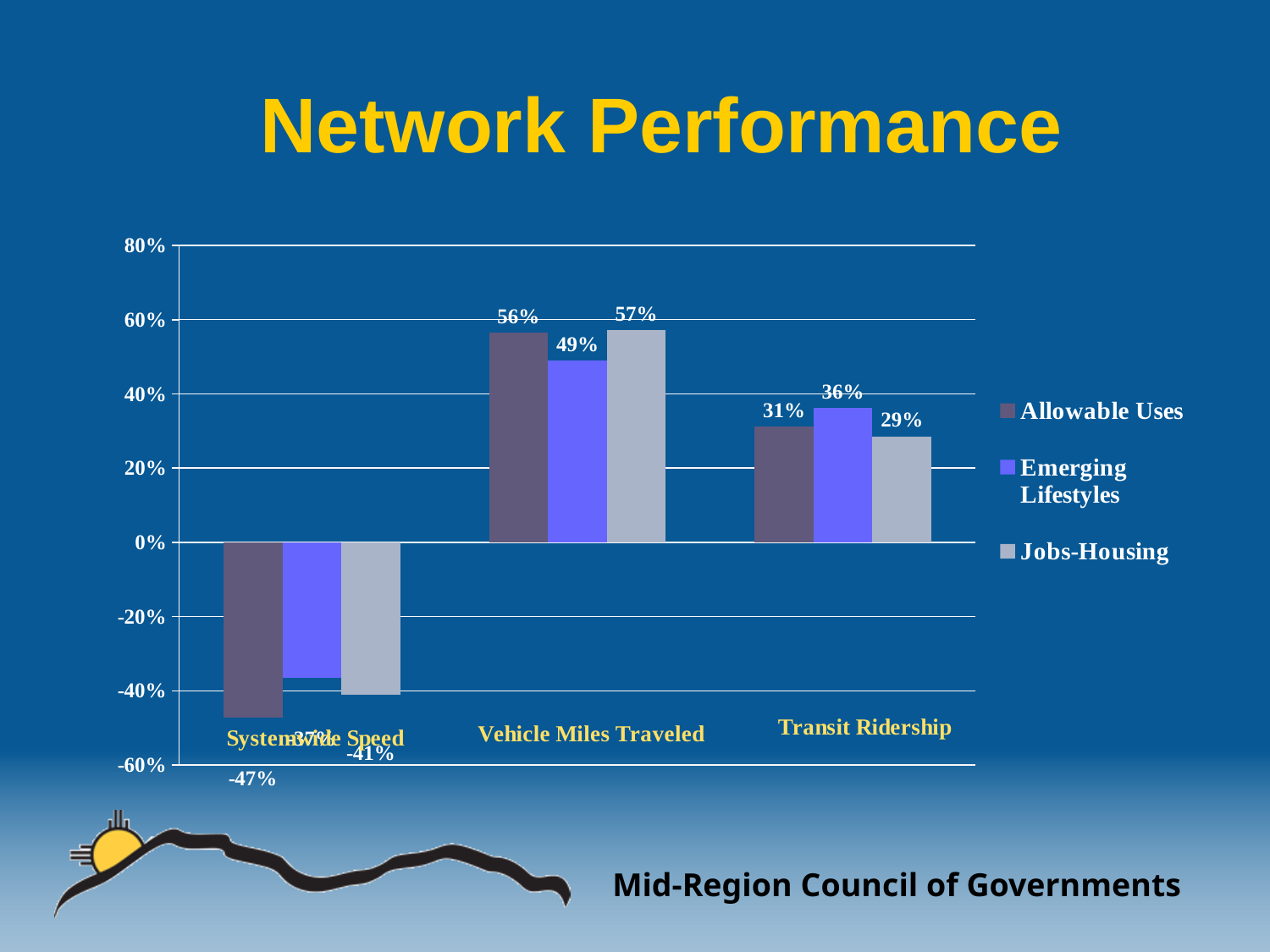
What is the value for Allowable Uses in the Systemwide Speed category? -47% Which series has the highest value in the Vehicle Miles Traveled category? Jobs-Housing What is the value for Allowable Uses in the Vehicle Miles Traveled category? 56% Is the value for Emerging Lifestyles in the Systemwide Speed category greater or less than -20%? less What is the value for Jobs-Housing in the Transit Ridership category? 29% Which series has the lowest value in the Transit Ridership category? Jobs-Housing What kind of chart is shown on the slide? bar chart What is the difference between the Jobs-Housing and Emerging Lifestyles values in the Vehicle Miles Traveled category? 8% How many categories are shown on the x axis of the chart? 3 How many series does the legend list? 3 What is the value for Emerging Lifestyles in the Vehicle Miles Traveled category? 49% In the Transit Ridership category, which is larger: Allowable Uses or Emerging Lifestyles? Emerging Lifestyles